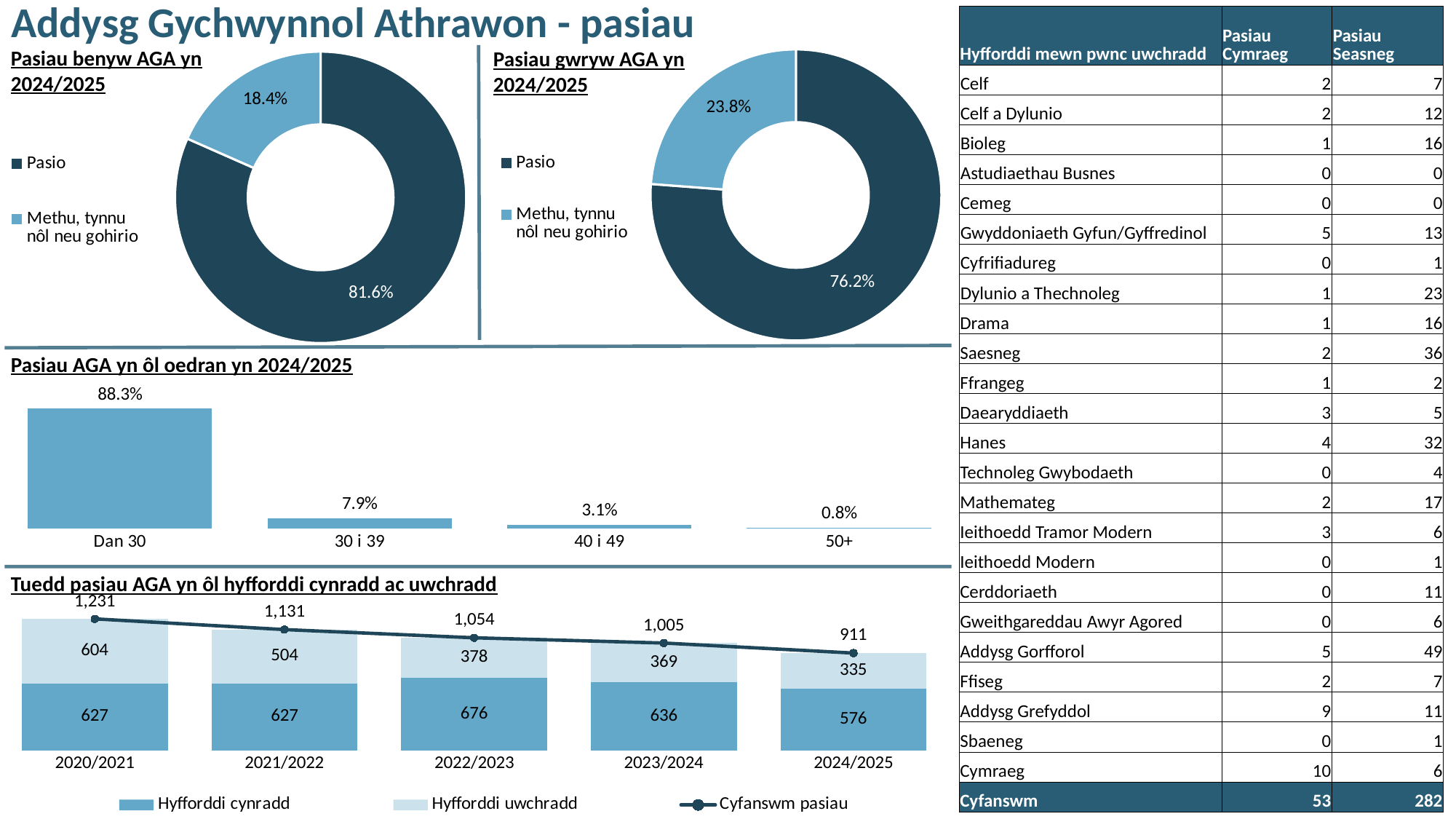
In the 'Pasiau AGA yn ôl oedran yn 2024/2025' chart, what is the value for Dan 30? 88.3% In the 'Pasiau AGA yn ôl oedran yn 2024/2025' chart, which age group has the lowest value? 50+ In the 'Pasiau AGA yn ôl oedran yn 2024/2025' chart, what is the difference between the values for 30 i 39 and 40 i 49? 4.8% In the 'Pasiau gwryw AGA yn 2024/2025' donut chart, what share is labelled for 'Methu, tynnu nôl neu gohirio'? 23.8% Comparing the two donut charts, which has the larger Pasio share: 'Pasiau benyw AGA yn 2024/2025' or 'Pasiau gwryw AGA yn 2024/2025'? Pasiau benyw AGA yn 2024/2025 How many series does the legend of the 'Tuedd pasiau AGA yn ôl hyfforddi cynradd ac uwchradd' chart list? 3 In the 'Tuedd pasiau AGA yn ôl hyfforddi cynradd ac uwchradd' chart, what is the total (Cyfanswm pasiau) for 2024/2025? 911 In the 'Tuedd pasiau AGA yn ôl hyfforddi cynradd ac uwchradd' chart, does the Cyfanswm pasiau line rise or fall from 2020/2021 to 2024/2025? Fall In the 'Tuedd pasiau AGA yn ôl hyfforddi cynradd ac uwchradd' chart, what is the value for Hyfforddi uwchradd in 2022/2023? 378 What kind of chart is 'Pasiau AGA yn ôl oedran yn 2024/2025'? Bar chart In the 'Pasiau benyw AGA yn 2024/2025' donut chart, what share is labelled for Pasio? 81.6% How many age categories are shown in the 'Pasiau AGA yn ôl oedran yn 2024/2025' chart? 4